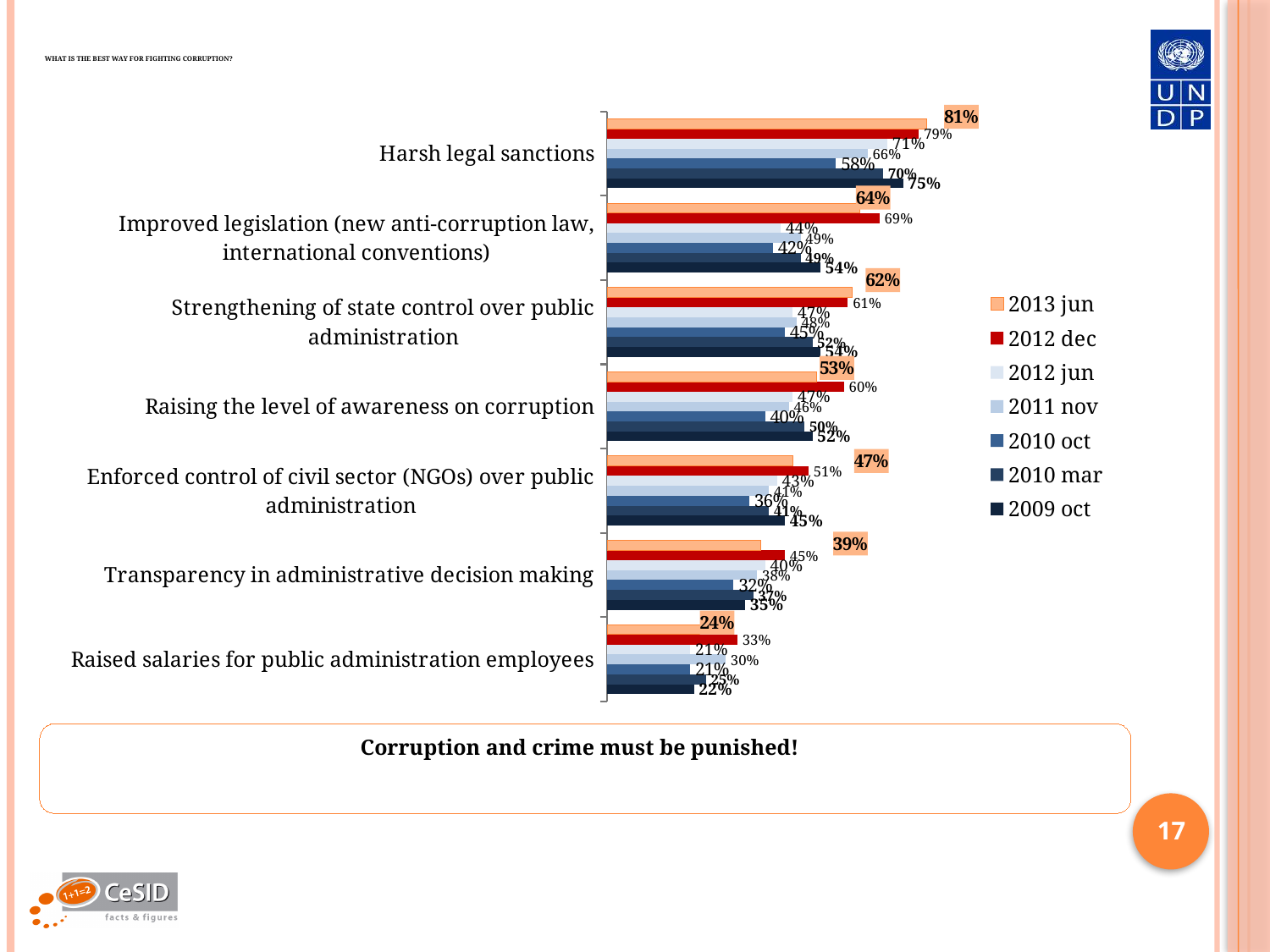
What is the difference between the 2013 jun values for Harsh legal sanctions and Improved legislation (new anti-corruption law, international conventions)? 17% What is the 2013 jun value for Raised salaries for public administration employees? 24% What is the 2013 jun value for Harsh legal sanctions? 81% Which category has the lowest 2012 dec value? Raised salaries for public administration employees What type of chart is shown on the slide? bar chart Which series is shown in orange in the legend? 2013 jun How many categories are shown on the chart? 7 Which is larger for Raising the level of awareness on corruption: the 2013 jun value or the 2012 dec value? 2012 dec Which category has the highest 2013 jun value? Harsh legal sanctions How many series does the legend list? 7 What is the 2012 dec value for Improved legislation (new anti-corruption law, international conventions)? 69% What is the 2012 dec value for Transparency in administrative decision making? 45%